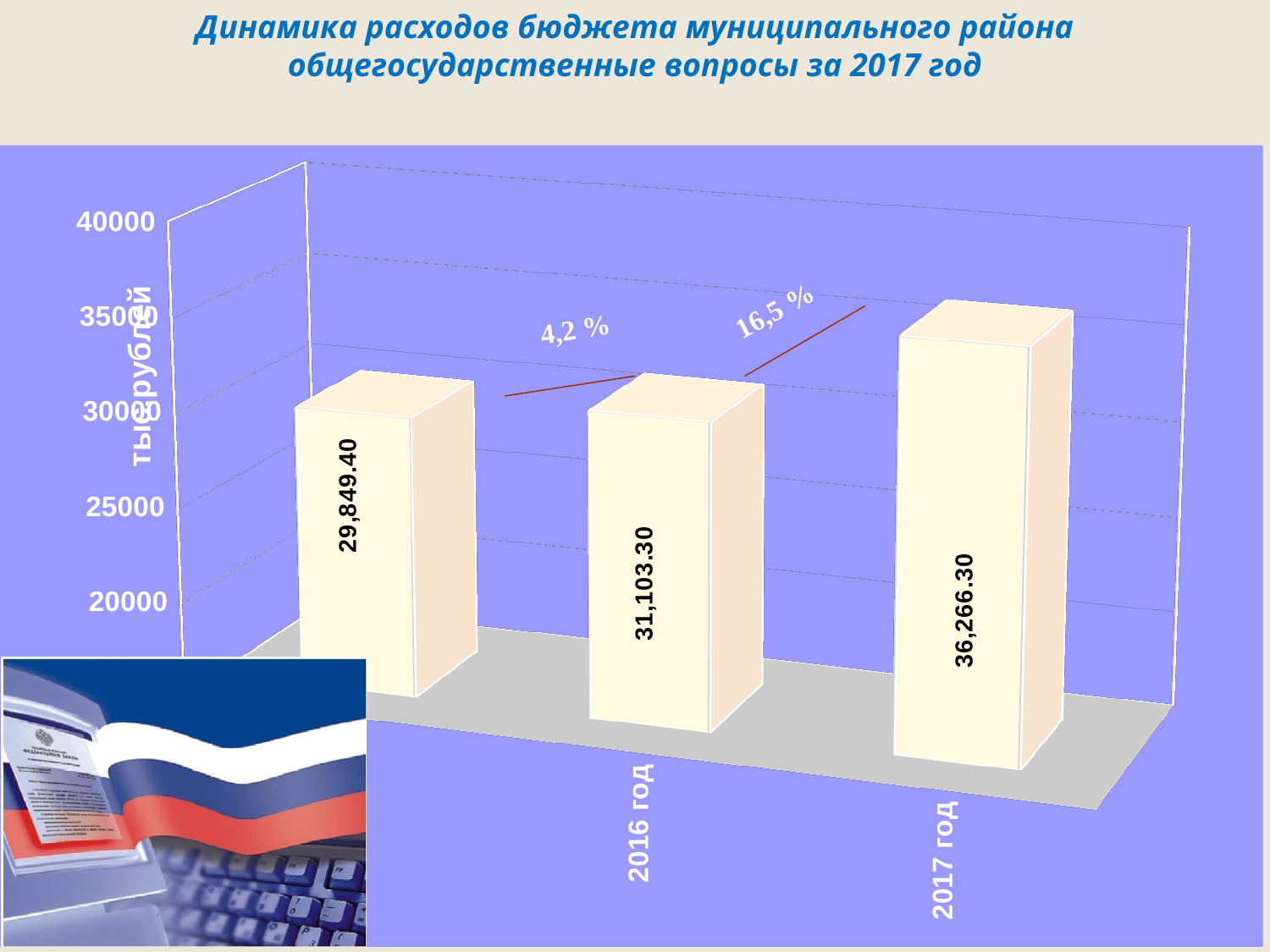
Which is larger, the value for 2016 год or for 2017 год? 2017 год What is the value for 2016 год? 31,103.30 Is the value for 2017 год greater or less than 35000? greater What is the value for 2017 год? 36,266.30 What kind of chart is shown on the slide? bar chart Which year has the highest value? 2017 год What is the value of the lowest bar on the chart? 29,849.40 What percentage change is annotated between the 2016 год and 2017 год bars? 16,5 % Is the value for 2016 год greater or less than 35000? less How many bars are shown on the chart? 3 What is the difference between the values for 2017 год and 2016 год? 5,163.00 Do the values rise or fall from left to right across the bars? rise